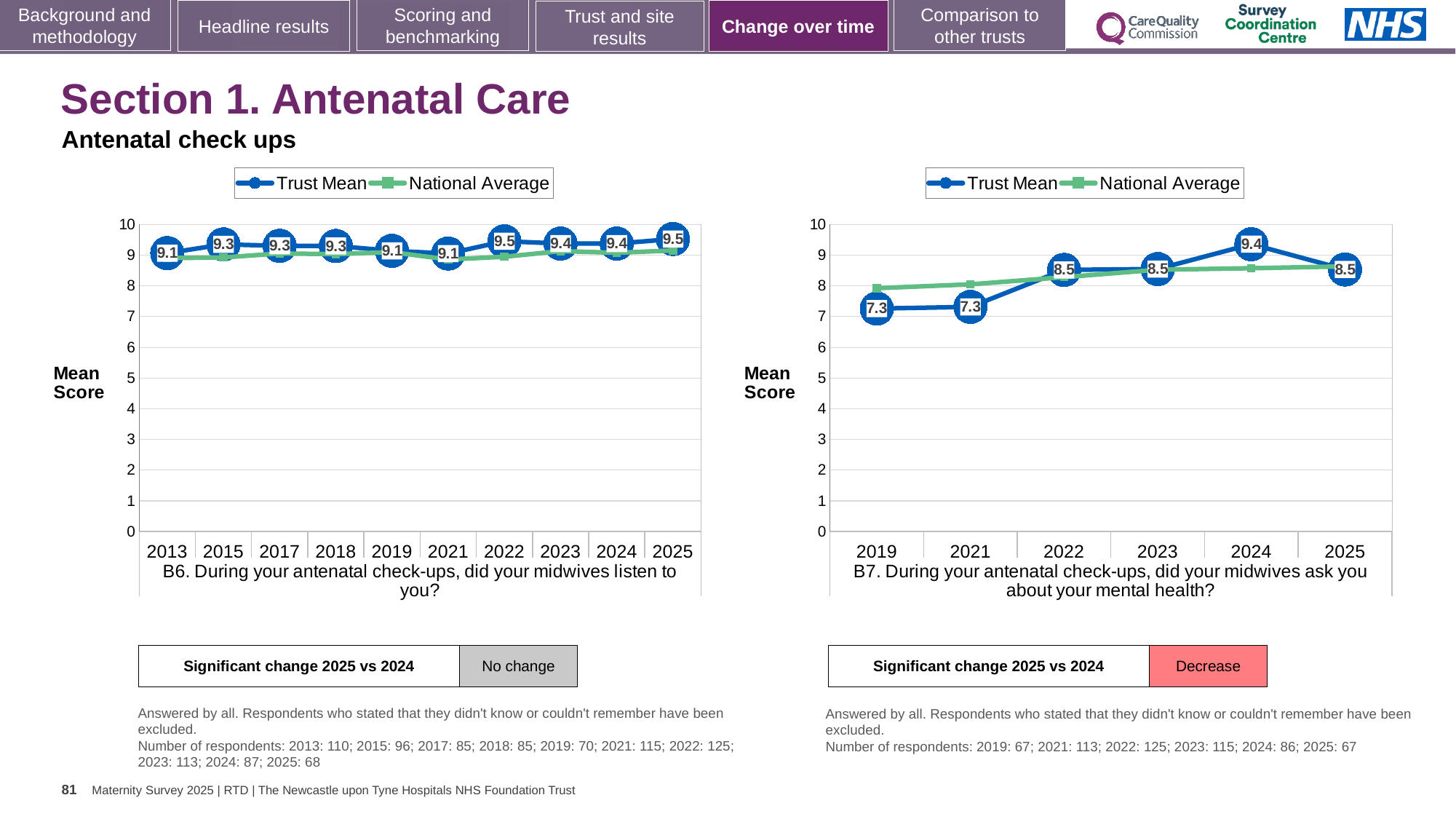
How many series does the legend of the B7 chart (right) list? 2 In the B7 chart (right), what is the difference between the Trust Mean for 2024 and 2025? 0.9 In the B6 chart (left), what is the difference between the Trust Mean for 2022 and 2021? 0.4 How many years are shown on the x axis of the B6 chart (left)? 10 In the B7 chart (right), what is the Trust Mean for 2019? 7.3 In the B7 chart (right), which year has the highest Trust Mean? 2024 What kind of chart is the B6 chart (left)? line chart In the B6 chart (left), what is the Trust Mean for 2013? 9.1 In the B7 chart (right), is the Trust Mean for 2022 larger or smaller than the Trust Mean for 2021? larger In the B6 chart (left), what is the Trust Mean for 2025? 9.5 In the B7 chart (right), what is the Trust Mean for 2024? 9.4 In the B7 chart (right), is the National Average for 2025 greater or less than 8? greater